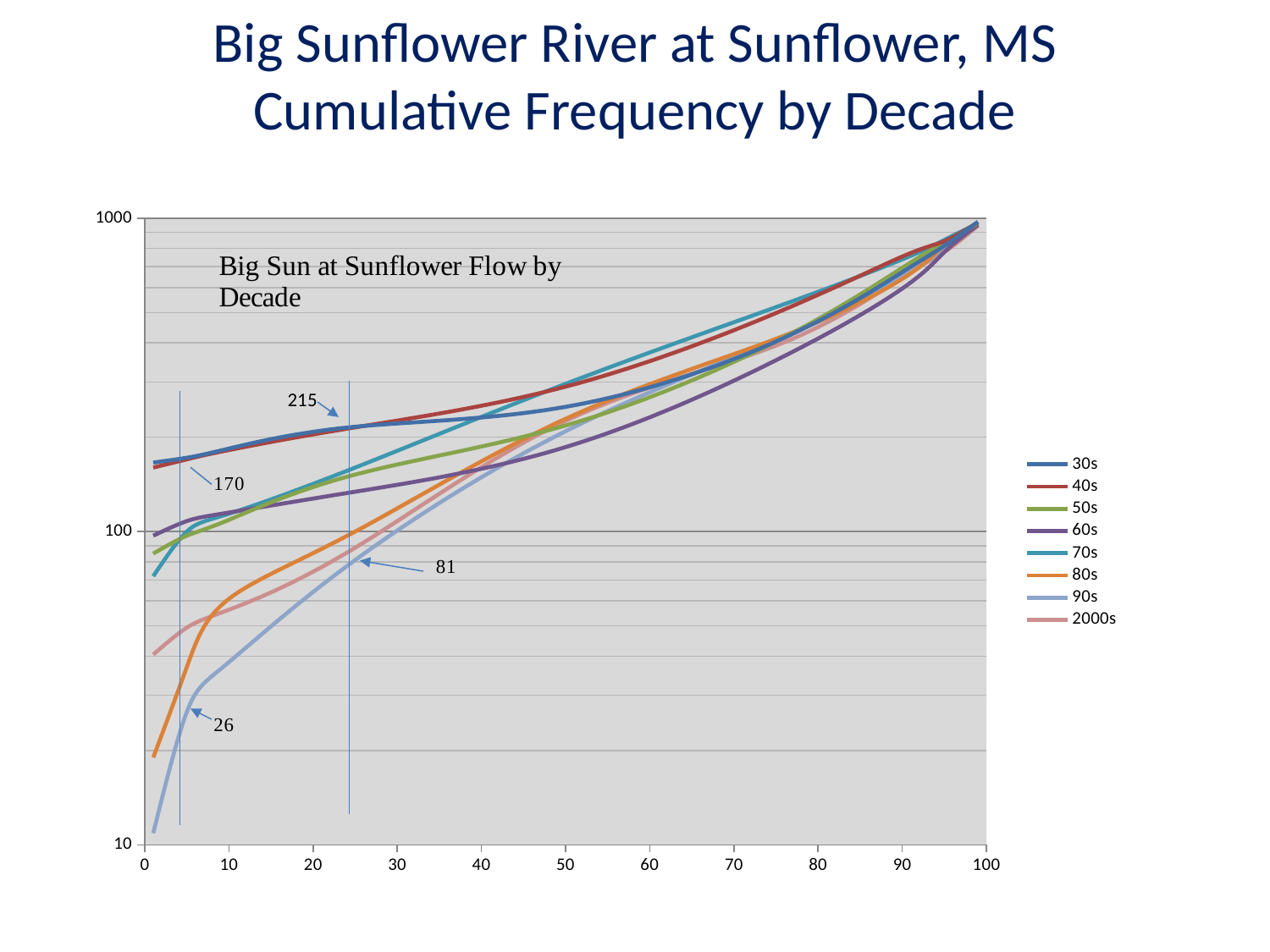
At x = 10, which series has the larger value, 30s or 80s? 30s Is the value of the 90s series at x = 1 greater or less than 100? less Is the value of the 60s series at x = 50 greater or less than 100? greater What value is annotated on the 90s line at the lower-left vertical marker line? 26 Do the values of the 90s series rise or fall as the x axis increases? rise What kind of chart is shown on the slide? line chart At x = 50, which series has the larger value, 40s or 60s? 40s How many series does the legend list? 8 What title is printed inside the plot area of the chart? Big Sun at Sunflower Flow by Decade Is the value of the 30s series at x = 1 greater or less than 100? greater Which series has the lowest value at the left end of the x axis (near 0)? 90s What value is annotated on the 30s line at the right vertical marker line (near x = 24)? 215